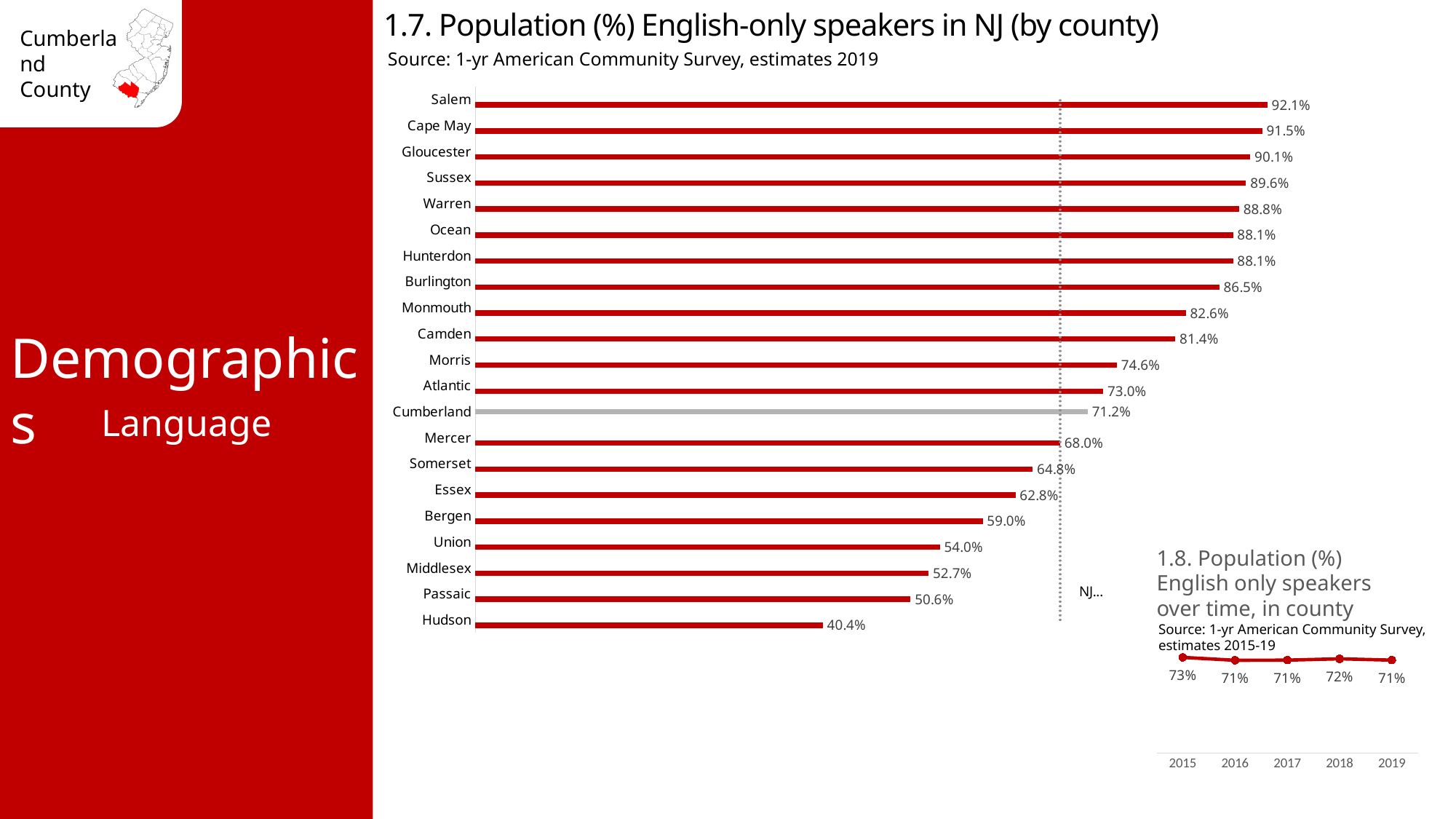
In the chart '1.7. Population (%) English-only speakers in NJ (by county)', what is the difference between Salem and Hudson? 51.7% In the chart '1.8. Population (%) English only speakers over time, in county', how many years are plotted? 5 In the chart '1.7. Population (%) English-only speakers in NJ (by county)', which is larger, Morris or Atlantic? Morris In the chart '1.7. Population (%) English-only speakers in NJ (by county)', how many counties are plotted? 21 In the chart '1.8. Population (%) English only speakers over time, in county', what is the value for 2015? 73% In the chart '1.7. Population (%) English-only speakers in NJ (by county)', what is the value for Cumberland? 71.2% In the chart '1.7. Population (%) English-only speakers in NJ (by county)', what is the value for Bergen? 59.0% In the chart '1.7. Population (%) English-only speakers in NJ (by county)', which bar is shown in grey rather than red? Cumberland In the chart '1.7. Population (%) English-only speakers in NJ (by county)', what is the value for Hudson? 40.4% In the chart '1.7. Population (%) English-only speakers in NJ (by county)', which county has the highest value? Salem What kind of chart is '1.7. Population (%) English-only speakers in NJ (by county)'? Bar chart In the chart '1.7. Population (%) English-only speakers in NJ (by county)', which county has the lowest value? Hudson